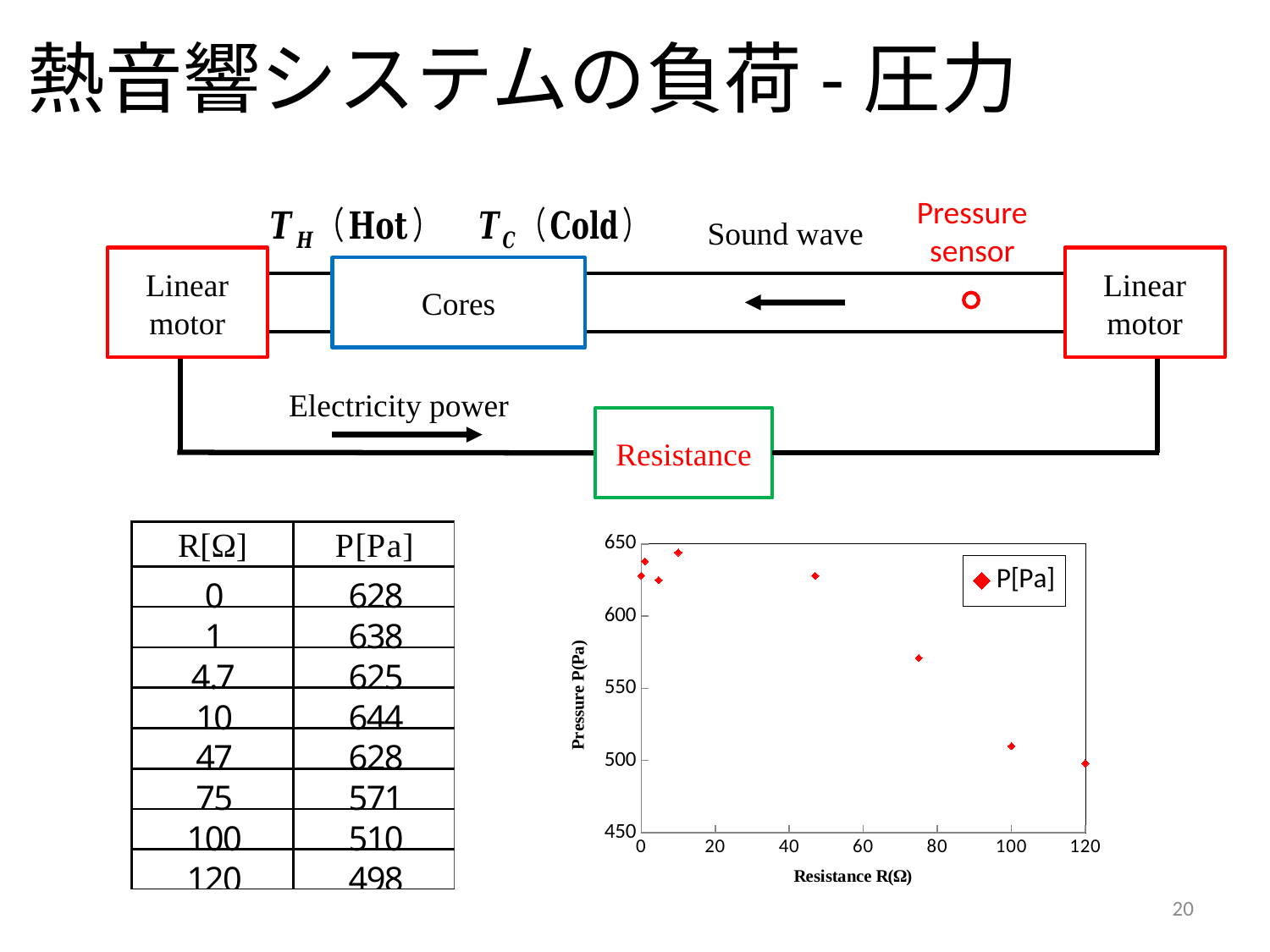
Is the pressure at 100 Ω greater or less than 550 Pa? less Does the pressure generally rise or fall as resistance increases along the x axis? fall How many data points are plotted in the chart? 8 What is the pressure P[Pa] at a resistance of 75 Ω? 571 How many series does the chart legend list? 1 What is the pressure P[Pa] at a resistance of 120 Ω? 498 What is the difference in pressure between 0 Ω and 120 Ω? 130 Pa What kind of chart is shown on the slide? scatter chart Which has the higher pressure, 47 Ω or 75 Ω? 47 Ω At which resistance value is the plotted pressure lowest? 120 Ω At which resistance value is the plotted pressure highest? 10 Ω Is the pressure at 75 Ω greater or less than 600 Pa? less